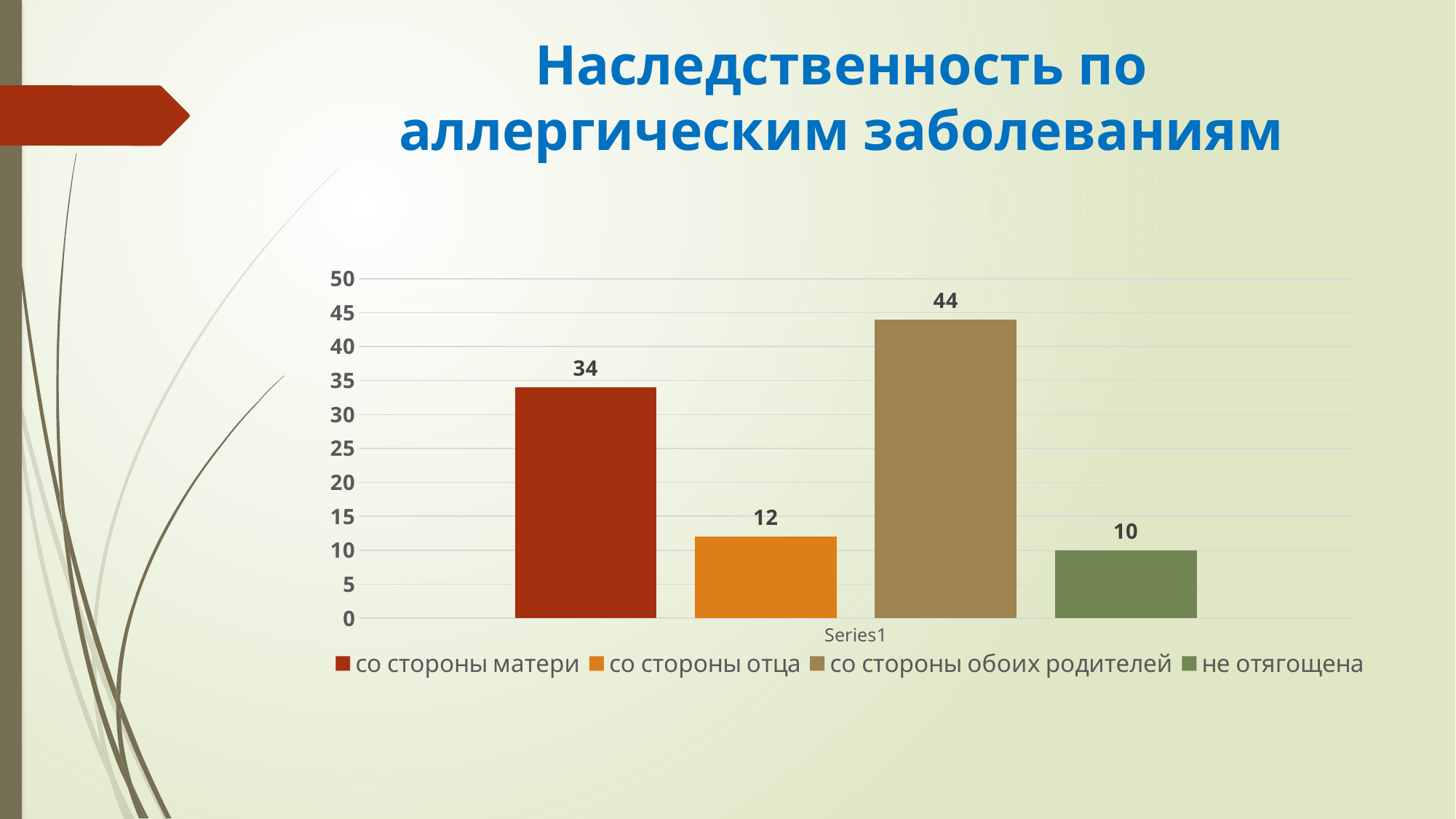
What is the difference between the values for 'со стороны обоих родителей' and 'со стороны матери'? 10 What is the value for 'со стороны отца'? 12 Which is larger, the value for 'со стороны отца' or the value for 'не отягощена'? со стороны отца Which legend entry has the lowest value? не отягощена Which legend entry has the highest value? со стороны обоих родителей What is the value for 'со стороны обоих родителей'? 44 What is the value for 'не отягощена'? 10 How many series does the legend list? 4 What is the value for 'со стороны матери'? 34 Is the value for 'со стороны матери' greater or less than 30? greater What is the title of the chart on the slide? Наследственность по аллергическим заболеваниям What kind of chart is shown on the slide? bar chart